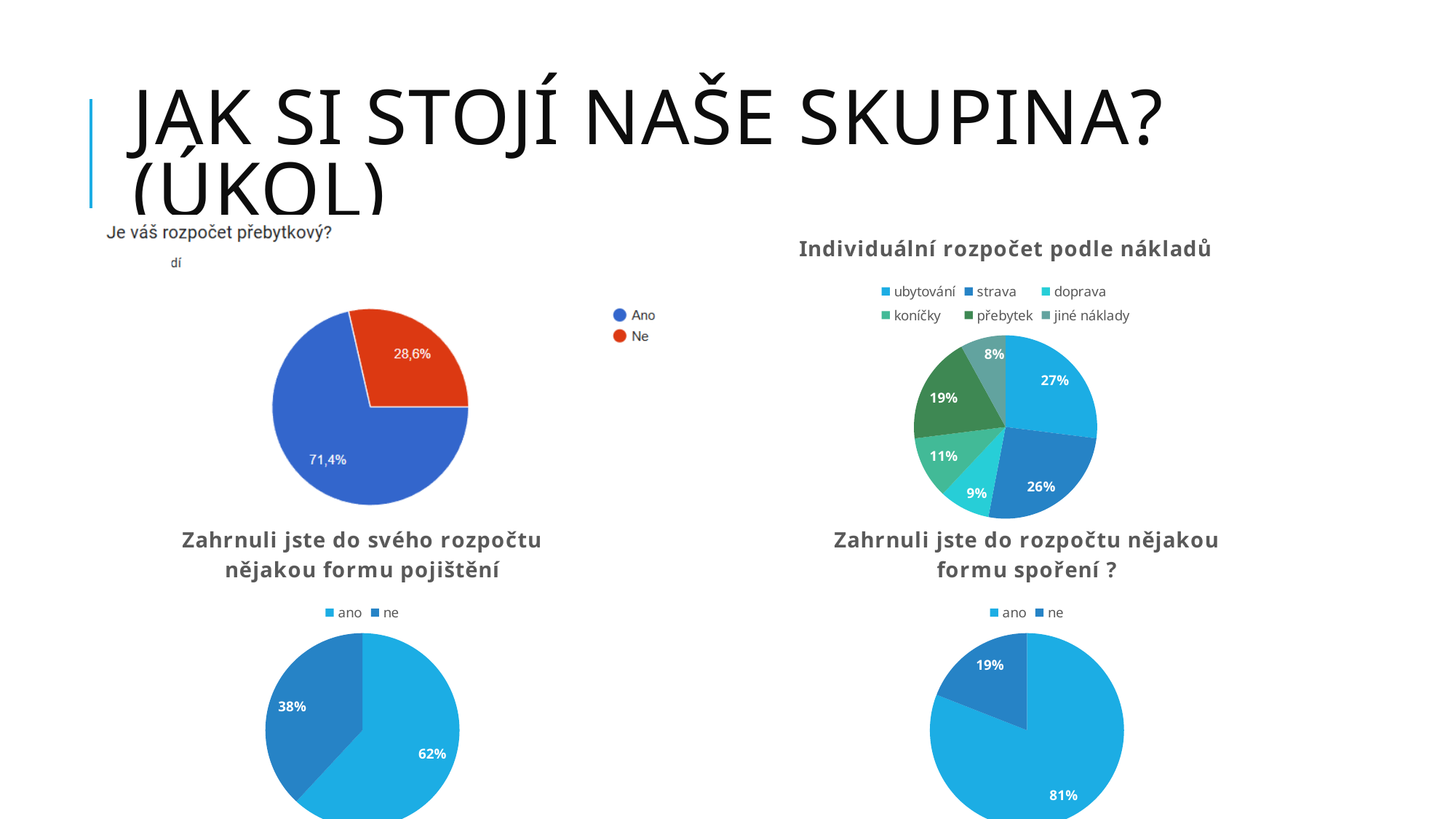
In the chart titled "Individuální rozpočet podle nákladů", which category has the largest share? ubytování In the chart titled "Individuální rozpočet podle nákladů", how many categories does the legend list? 6 In the chart titled "Individuální rozpočet podle nákladů", what is the difference between "přebytek" and "doprava"? 10% How many pie charts are shown on the slide? 4 In the chart titled "Individuální rozpočet podle nákladů", which category has the smallest share? jiné náklady What type of chart is the one titled "Zahrnuli jste do rozpočtu nějakou formu spoření ?"? pie chart In the chart titled "Je váš rozpočet přebytkový?", what share of the pie is "Ano"? 71,4% In the chart titled "Individuální rozpočet podle nákladů", what is the value for "strava"? 26% In the chart titled "Zahrnuli jste do rozpočtu nějakou formu spoření ?", what share of the pie is "ano"? 81% In the chart titled "Zahrnuli jste do svého rozpočtu nějakou formu pojištění", what is the value for "ne"? 38% In the chart titled "Je váš rozpočet přebytkový?", what is the value for "Ne"? 28,6% In the chart titled "Individuální rozpočet podle nákladů", which is larger, "koníčky" or "doprava"? koníčky